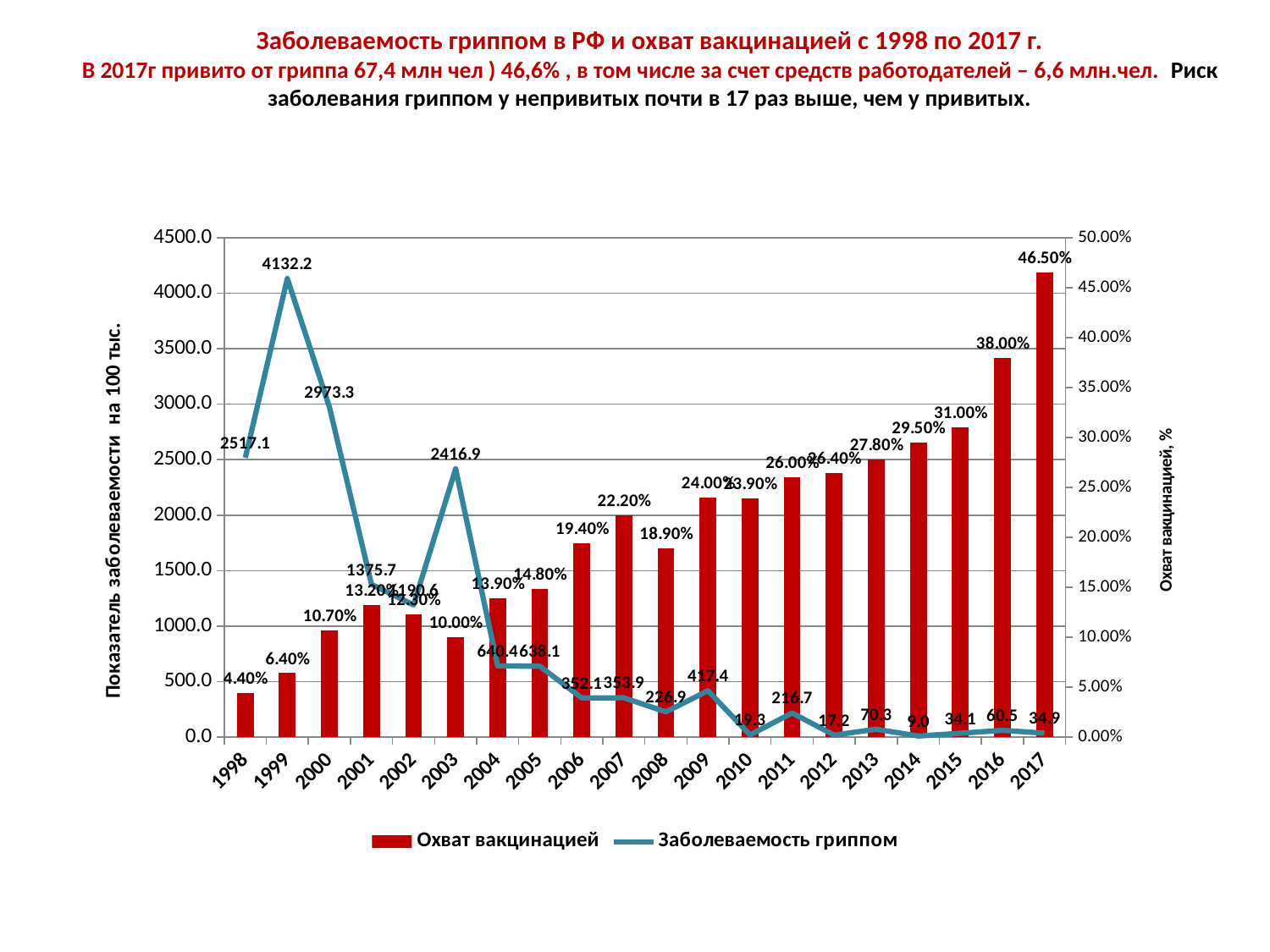
Which year has the highest flu incidence (Заболеваемость гриппом)? 1999 What is the flu incidence (Заболеваемость гриппом) value for 1999? 4132.2 What is the flu incidence (Заболеваемость гриппом) value for 2003? 2416.9 What is the vaccination coverage (Охват вакцинацией) for 2017? 46.50% What is the vaccination coverage (Охват вакцинацией) for 2007? 22.20% Which year has the lowest vaccination coverage (Охват вакцинацией)? 1998 Which series is drawn as a line rather than bars? Заболеваемость гриппом Which year has the higher flu incidence, 2000 or 2003? 2000 How many years are shown on the x axis? 20 Does the vaccination coverage (Охват вакцинацией) generally rise or fall from 2009 to 2017? rise How many series does the legend list? 2 What is the difference in vaccination coverage between 2017 and 2016? 8.50%